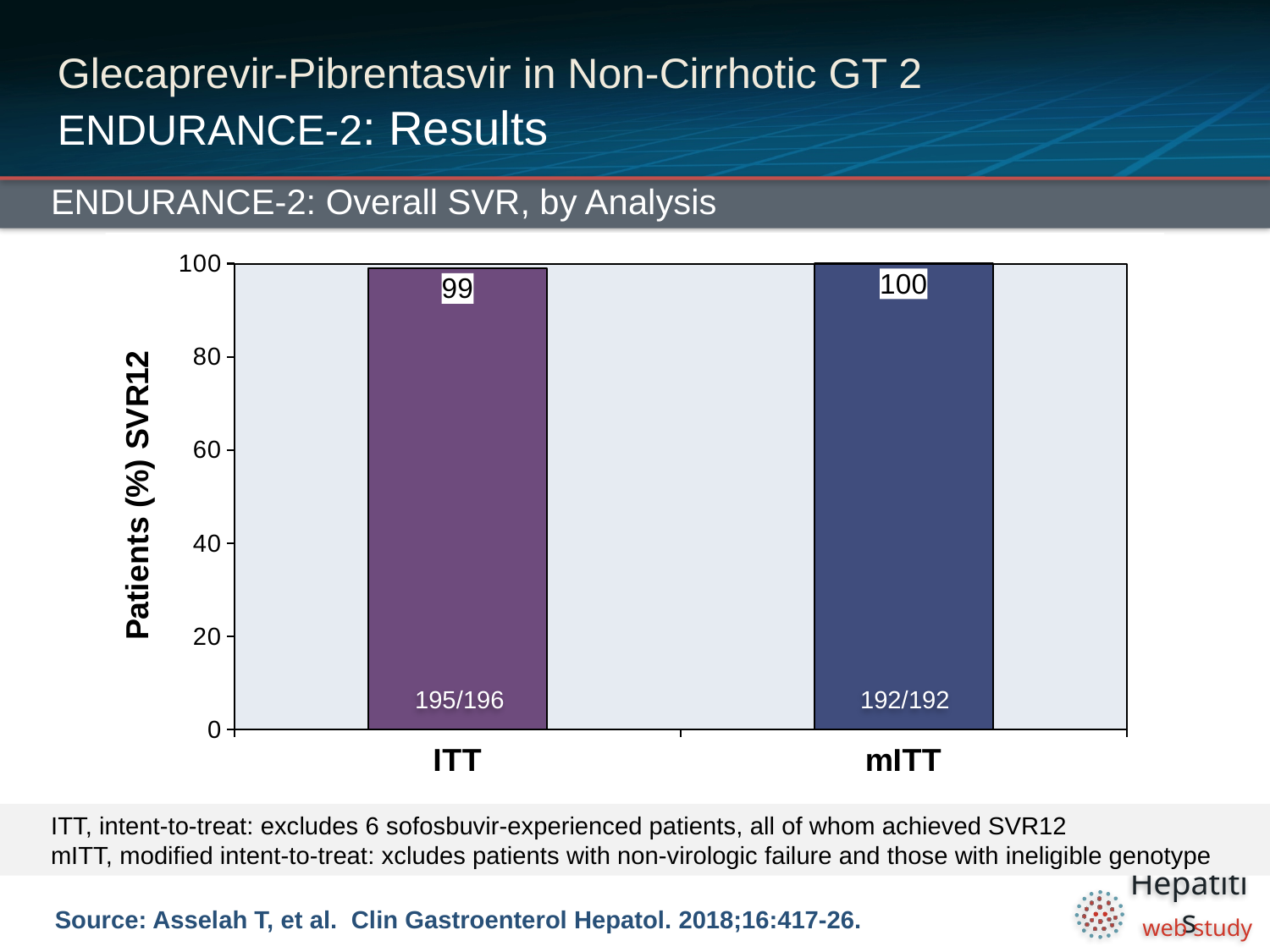
What fraction of patients is printed on the mITT bar? 192/192 What is the difference between the mITT and ITT SVR12 values? 1 How many categories are shown on the x axis? 2 Which analysis has the lower SVR12 value? ITT What is the SVR12 value for ITT? 99 Is the value for ITT greater or less than 80? greater What fraction of patients is printed on the ITT bar? 195/196 What kind of chart is shown? bar chart What is the title of the chart? ENDURANCE-2: Overall SVR, by Analysis What is the SVR12 value for mITT? 100 Which analysis has the higher SVR12 value? mITT What is the y-axis label of the chart? Patients (%) SVR12